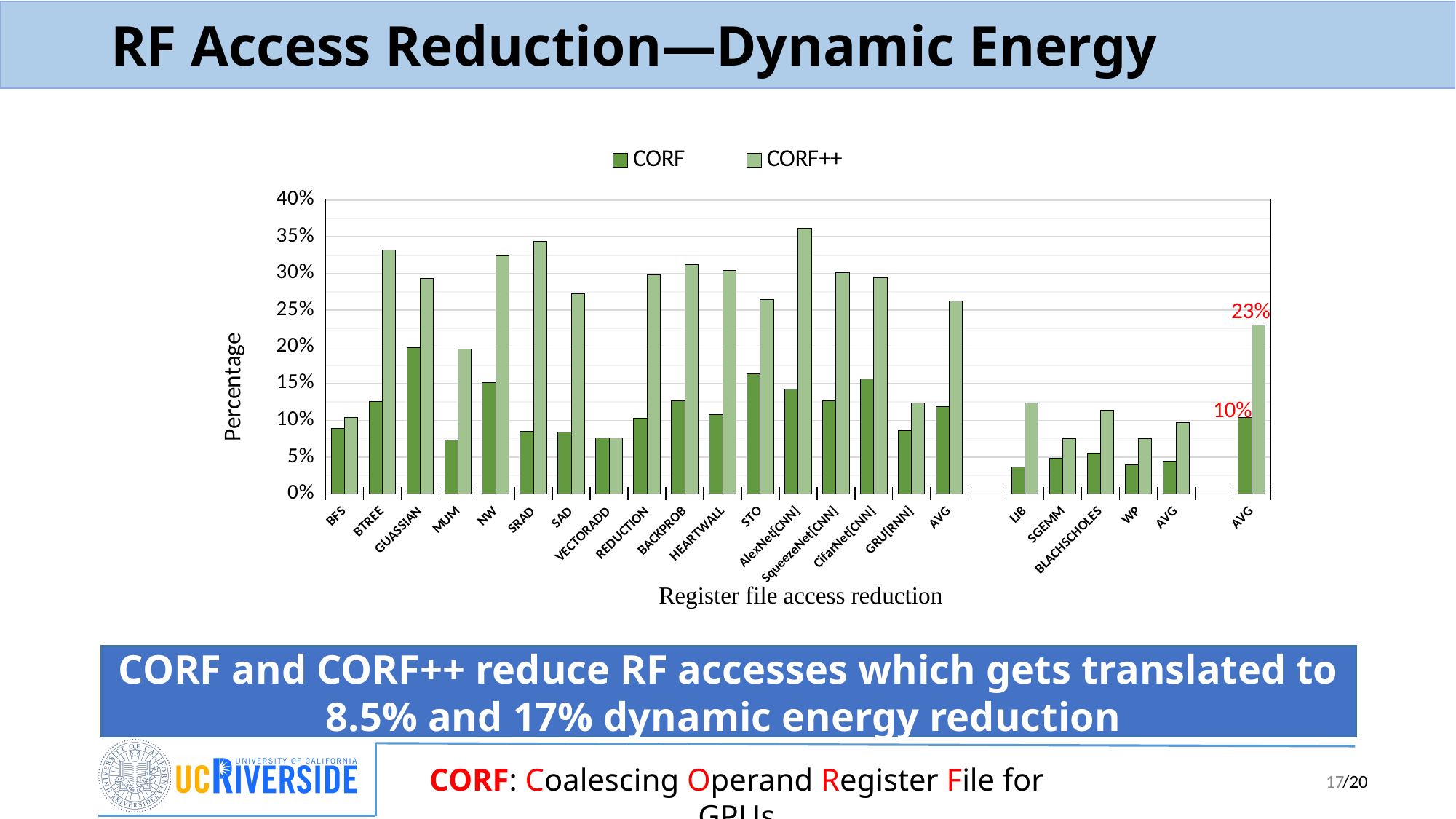
Is the CORF++ value for NW greater or less than 30%? greater What kind of chart is shown on the slide? Bar chart What is the CORF++ value for the final AVG category (rightmost bar pair)? 23% How many series does the legend list? 2 What is the CORF value for the final AVG category (rightmost bar pair)? 10% Is the CORF value for GUASSIAN greater or less than 15%? greater For BFS, which series has the larger value, CORF or CORF++? CORF++ What is the label on the vertical axis of the chart? Percentage What is the difference between the CORF++ and CORF values for the final AVG category (rightmost bar pair)? 13% Is the CORF++ value for SGEMM greater or less than 10%? less What is the title shown below the horizontal axis of the chart? Register file access reduction Which category has the highest CORF++ value? AlexNet[CNN]